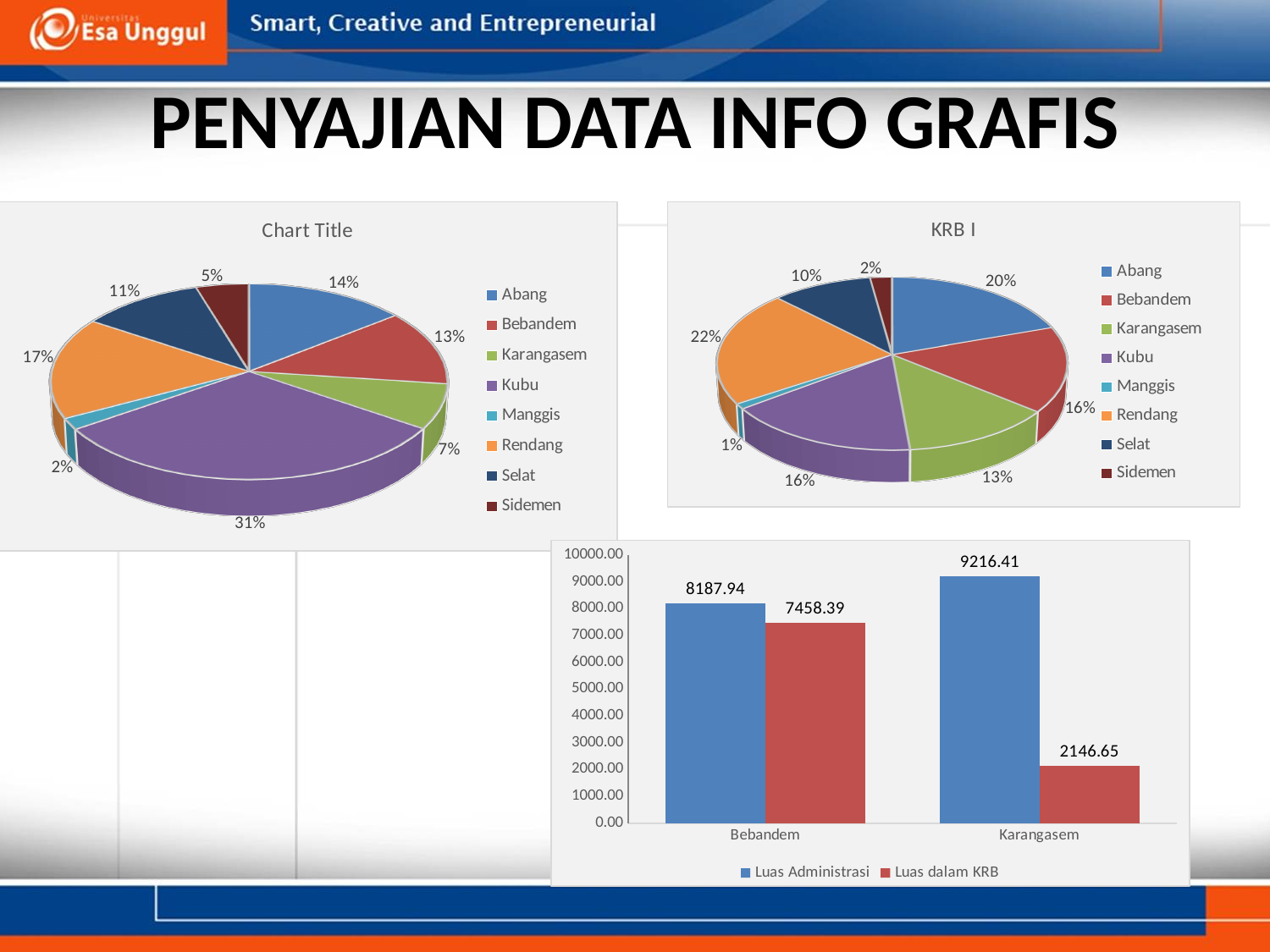
In the bottom bar chart, what is the value of Luas dalam KRB for Bebandem? 7458.39 In the pie chart titled 'Chart Title', what share does Kubu have? 31% What kind of chart is the bottom chart on the slide? Bar chart In the bottom bar chart, what is the difference between Luas Administrasi and Luas dalam KRB for Karangasem? 7069.76 In the pie chart titled 'Chart Title', which category has the smallest share? Manggis In the bottom bar chart, which category has the lower Luas dalam KRB value? Karangasem In the bottom bar chart, what is the value of Luas Administrasi for Karangasem? 9216.41 In the bottom bar chart, how many series does the legend list? 2 In the pie chart titled 'KRB I', how many categories does the legend list? 8 In the pie chart titled 'KRB I', what share does Rendang have? 22% In the pie chart titled 'Chart Title', which is larger, the share for Abang or the share for Selat? Abang In the pie chart titled 'KRB I', which category has the largest share? Rendang